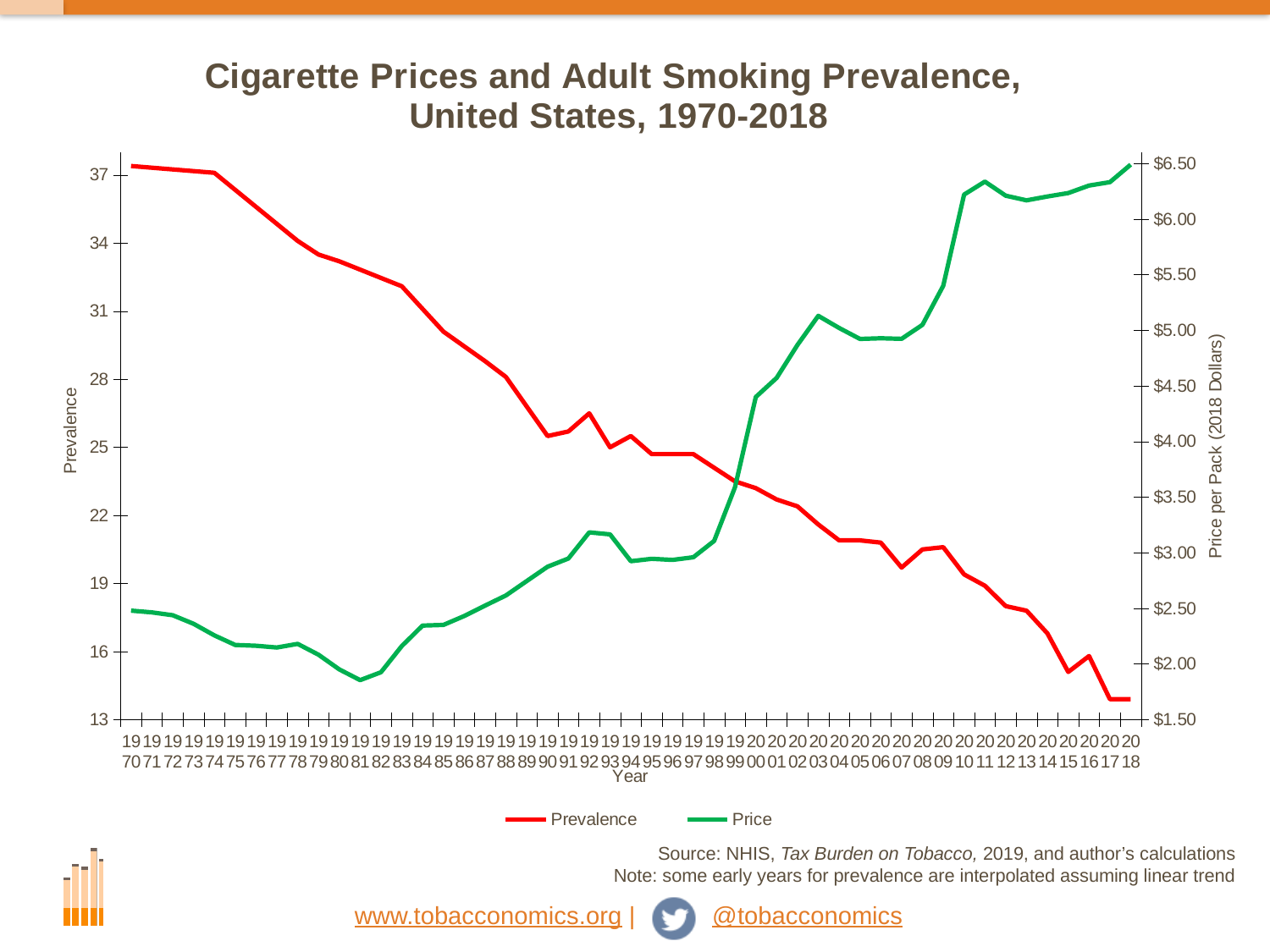
What is the label of the right-hand vertical axis? Price per Pack (2018 Dollars) Does the Price series rise or fall overall from 1970 to 2018? Rise What kind of chart is shown on the slide? Line chart Is the Price value for 1981 greater or less than $2.00? less Is the Price value for 2018 greater or less than $6.00? greater What is the title of the chart? Cigarette Prices and Adult Smoking Prevalence, United States, 1970-2018 Which year has the higher Prevalence value, 1980 or 2000? 1980 Is the Prevalence value for 1970 greater or less than 34? greater How many series does the legend list? 2 In which year is the Price series at its lowest? 1981 Does the Prevalence series rise or fall from 1970 to 2018? Fall